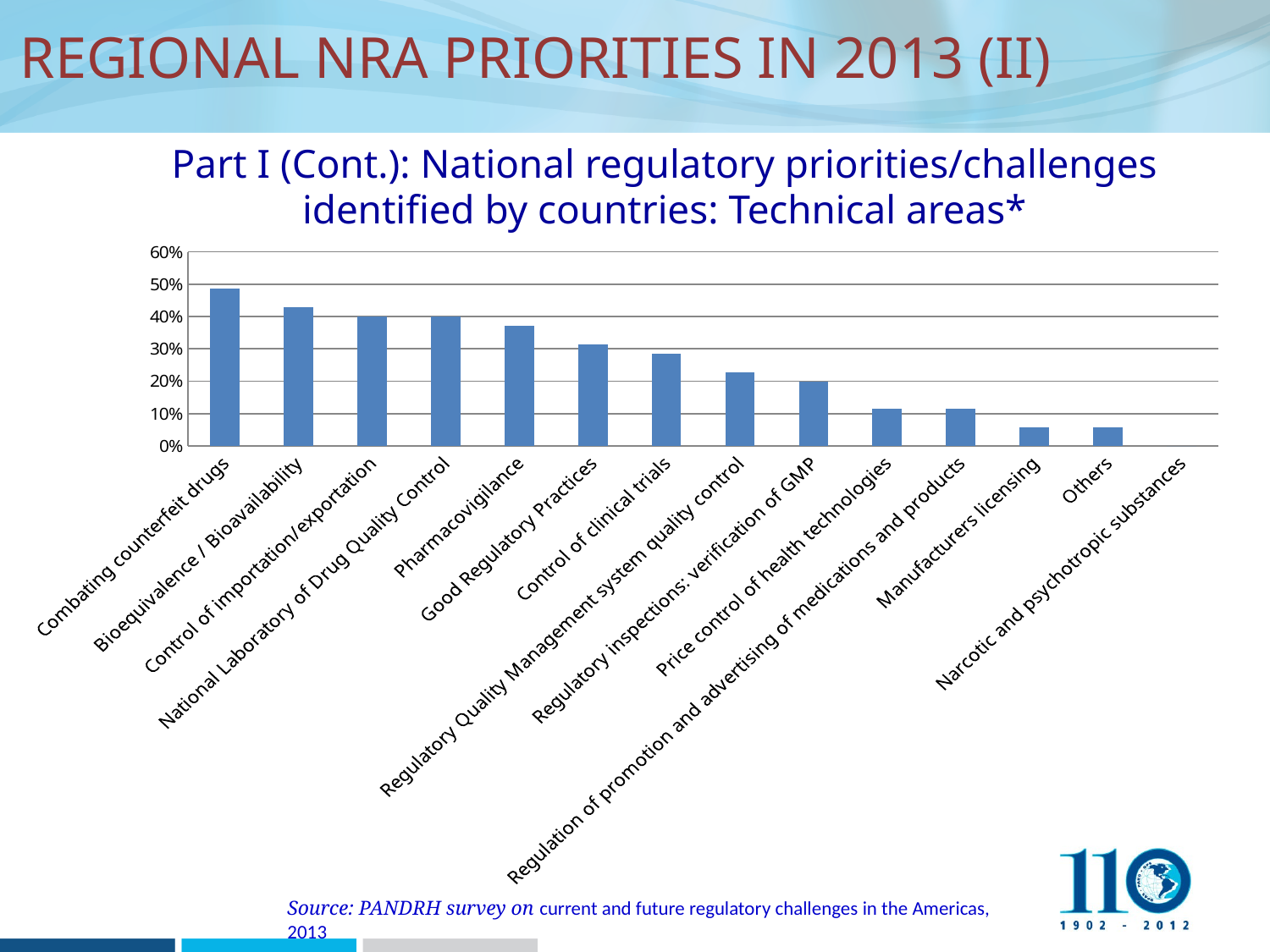
What is the maximum value shown on the chart's vertical axis? 60% Is the value for Manufacturers licensing greater or less than 10%? less Which is larger, the value for Bioequivalence / Bioavailability or the value for Good Regulatory Practices? Bioequivalence / Bioavailability Which technical area has the highest value in the chart? Combating counterfeit drugs Which is larger, the value for Regulatory inspections: verification of GMP or the value for Price control of health technologies? Regulatory inspections: verification of GMP Is the value for Regulatory Quality Management system quality control greater or less than 20%? greater What kind of chart is shown on the slide? bar chart Is the value for Control of clinical trials greater or less than 30%? less How many technical area categories are shown on the x axis of the chart? 14 Do the bar values generally rise or fall moving from left to right along the x axis? fall